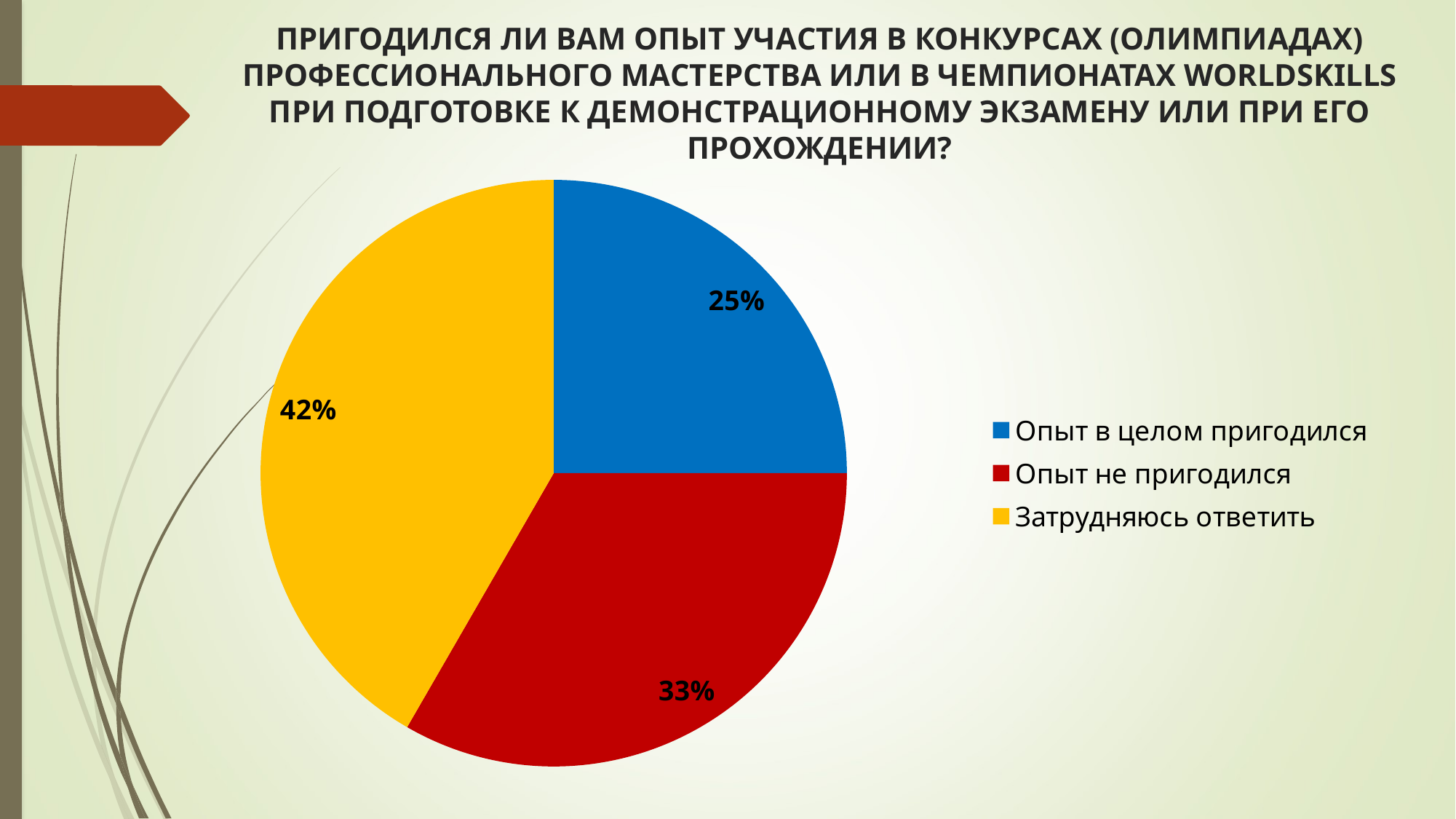
What share of respondents answered "Опыт не пригодился"? 33% What is the difference in percentage points between "Затрудняюсь ответить" and "Опыт в целом пригодился"? 17 What type of chart is shown on the slide? Pie chart What share of respondents answered "Затрудняюсь ответить"? 42% What share of respondents answered "Опыт в целом пригодился"? 25% Which answer option has the largest share of the pie? Затрудняюсь ответить What colour is the slice for "Опыт не пригодился"? Red Which answer option has the smallest share of the pie? Опыт в целом пригодился Which is larger: the share for "Опыт не пригодился" or the share for "Опыт в целом пригодился"? Опыт не пригодился How many slices does the pie chart have? 3 What is the difference in percentage points between "Опыт не пригодился" and "Опыт в целом пригодился"? 8 What colour is the slice for "Затрудняюсь ответить"? Yellow